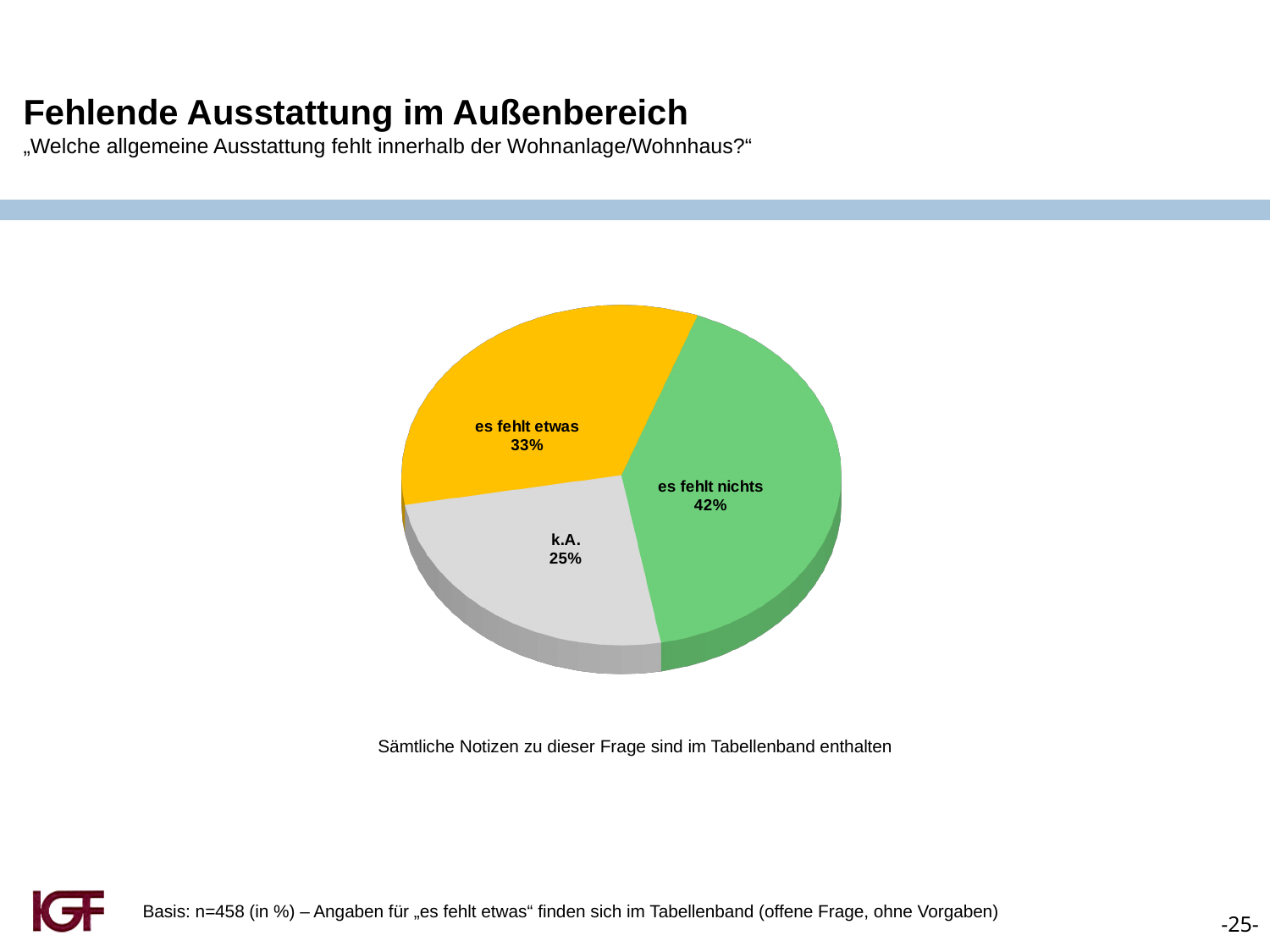
Which is larger, the share for "es fehlt etwas" or the share for "k.A."? es fehlt etwas What colour is the "es fehlt nichts" slice? green What kind of chart is shown on the slide? pie chart What is the difference in percentage points between "es fehlt nichts" and "es fehlt etwas"? 9 What share of the pie is labelled "k.A."? 25% Which slice of the pie is the smallest? k.A. How many slices does the pie chart have? 3 Which slice of the pie is the largest? es fehlt nichts What share of the pie is labelled "es fehlt nichts"? 42% What is the title of the slide containing the chart? Fehlende Ausstattung im Außenbereich What is the difference in percentage points between "es fehlt etwas" and "k.A."? 8 What share of the pie is labelled "es fehlt etwas"? 33%